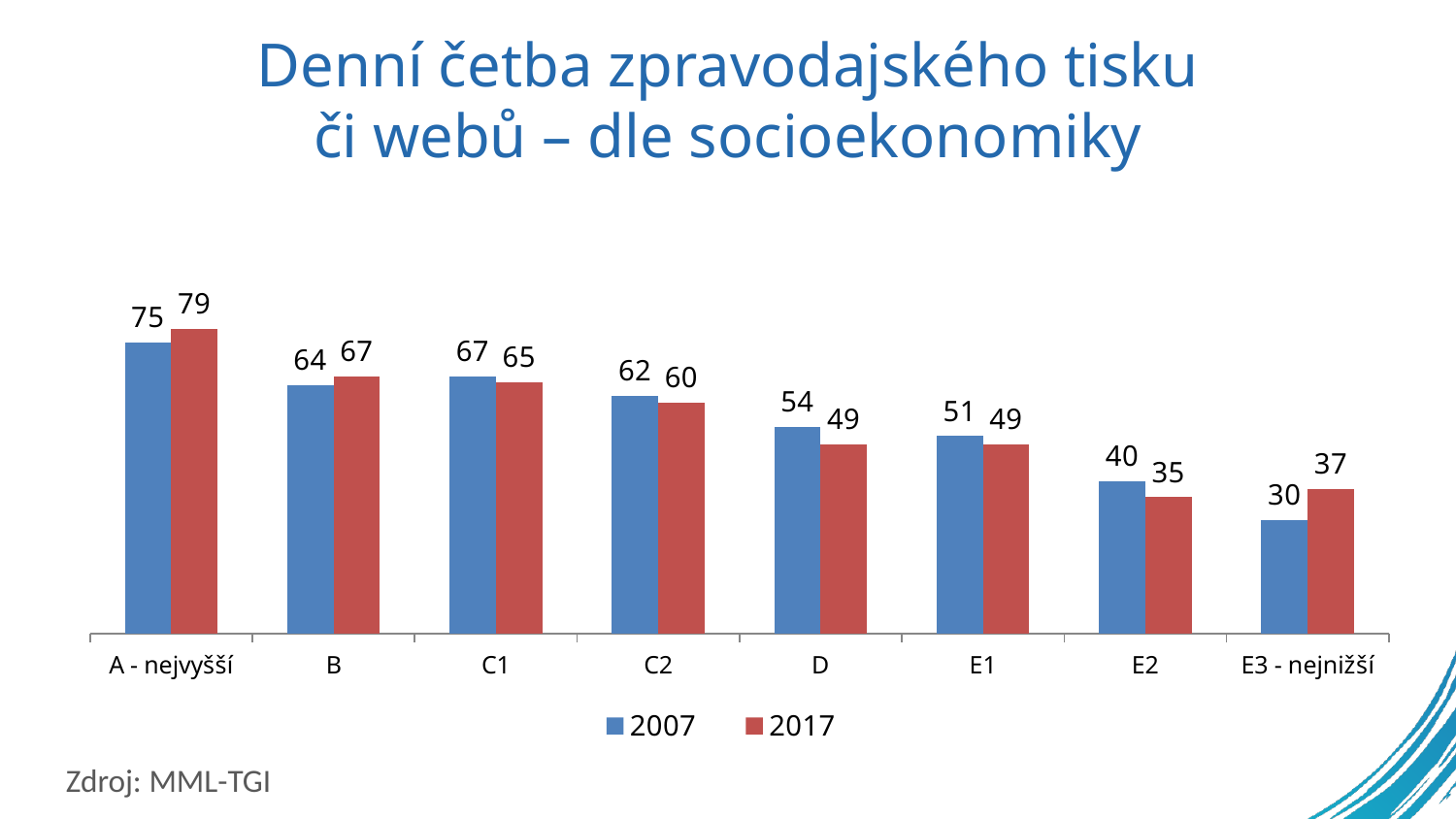
What is the 2007 value for category D? 54 How many categories are shown on the x axis? 8 Do the 2007 values generally rise or fall from A - nejvyšší to E3 - nejnižší? fall Which category has the lowest 2007 value? E3 - nejnižší Which category has the highest 2017 value? A - nejvyšší Which is larger for category C1, the 2007 value or the 2017 value? 2007 What is the 2017 value for category E2? 35 What is the 2017 value for category A - nejvyšší? 79 What is the difference between the 2007 values for category B and category E2? 24 What kind of chart is shown on the slide? bar chart What is the difference between the 2007 and 2017 values for category E3 - nejnižší? 7 How many series does the legend list? 2